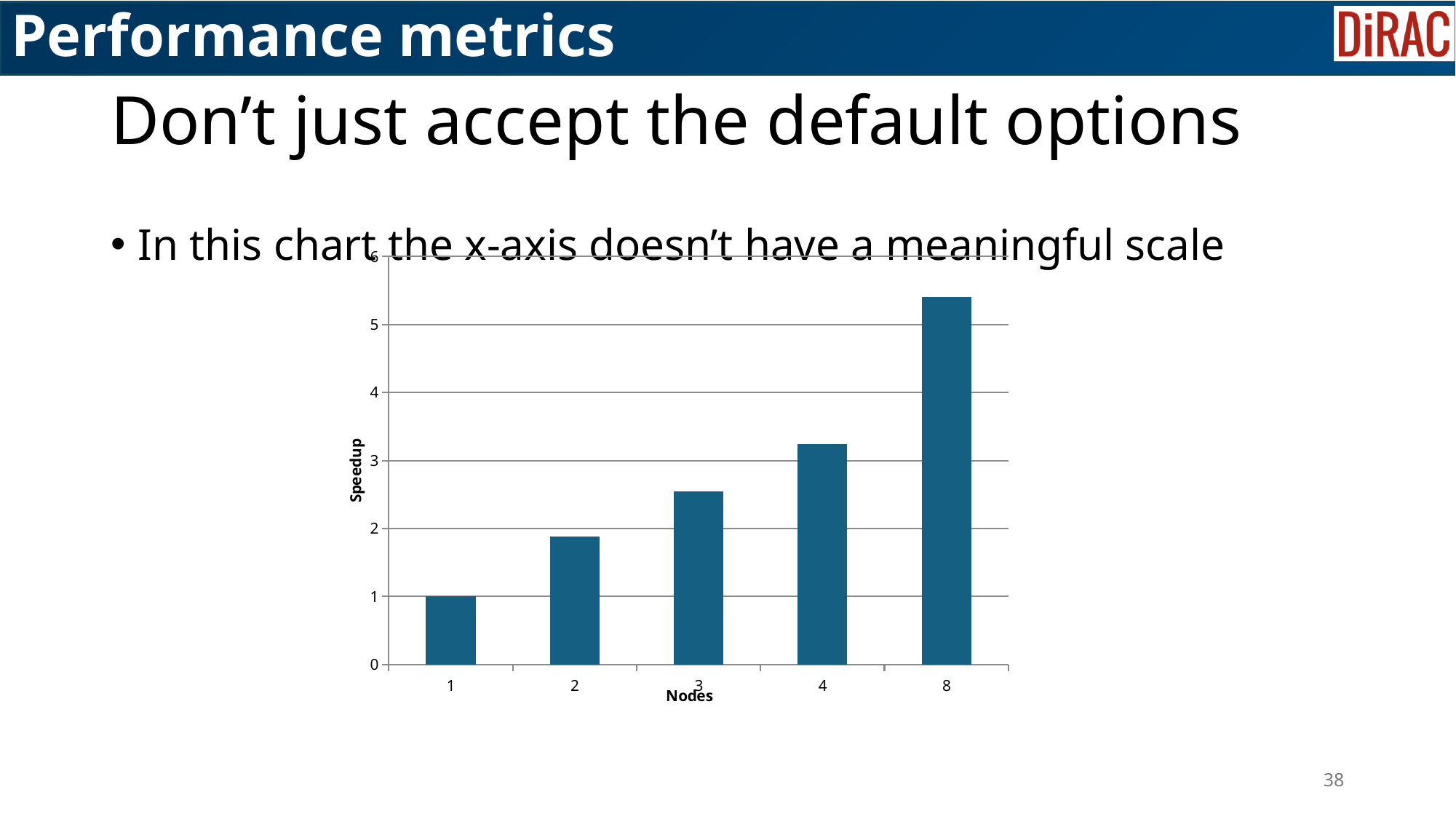
What is the label of the y-axis? Speedup Is the speedup for 2 nodes greater or less than 2? less Do the speedup values rise or fall as the number of nodes increases along the x-axis? rise Which has a larger speedup, 4 nodes or 8 nodes? 8 nodes Is the speedup for 8 nodes greater or less than 5? greater Is the speedup for 3 nodes greater or less than 3? less How many bars (node counts) are plotted in the chart? 5 What is the speedup for 1 node? 1 Which node count has the lowest speedup? 1 Which node count has the highest speedup? 8 What kind of chart is shown on the slide? bar chart